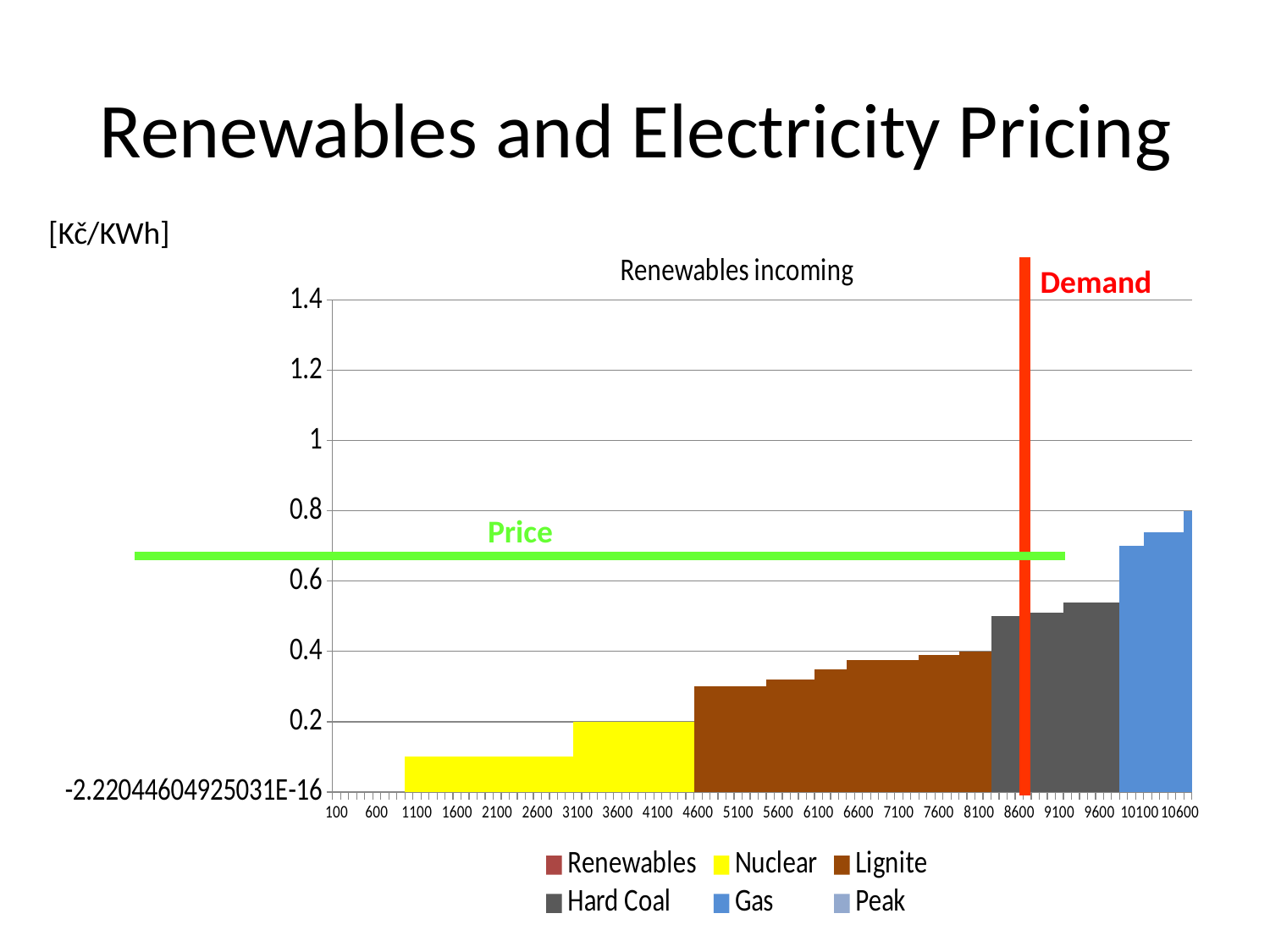
What is the value of the bar at the 3600 position on the x axis? 0.2 Is the value of the bar at 9600 greater or less than 0.6? less Which colour represents Nuclear in the chart legend? yellow What kind of chart is shown on the slide? bar chart Do the bar values rise or fall as you move from left to right along the x axis? rise Is the value of the bar at 10100 greater or less than 0.6? greater Which of the bars at 8600 and 10100 is taller? 10100 What is the title of the chart? Renewables incoming Is the value of the bar at 1600 greater or less than 0.2? less How many series does the legend of the chart list? 6